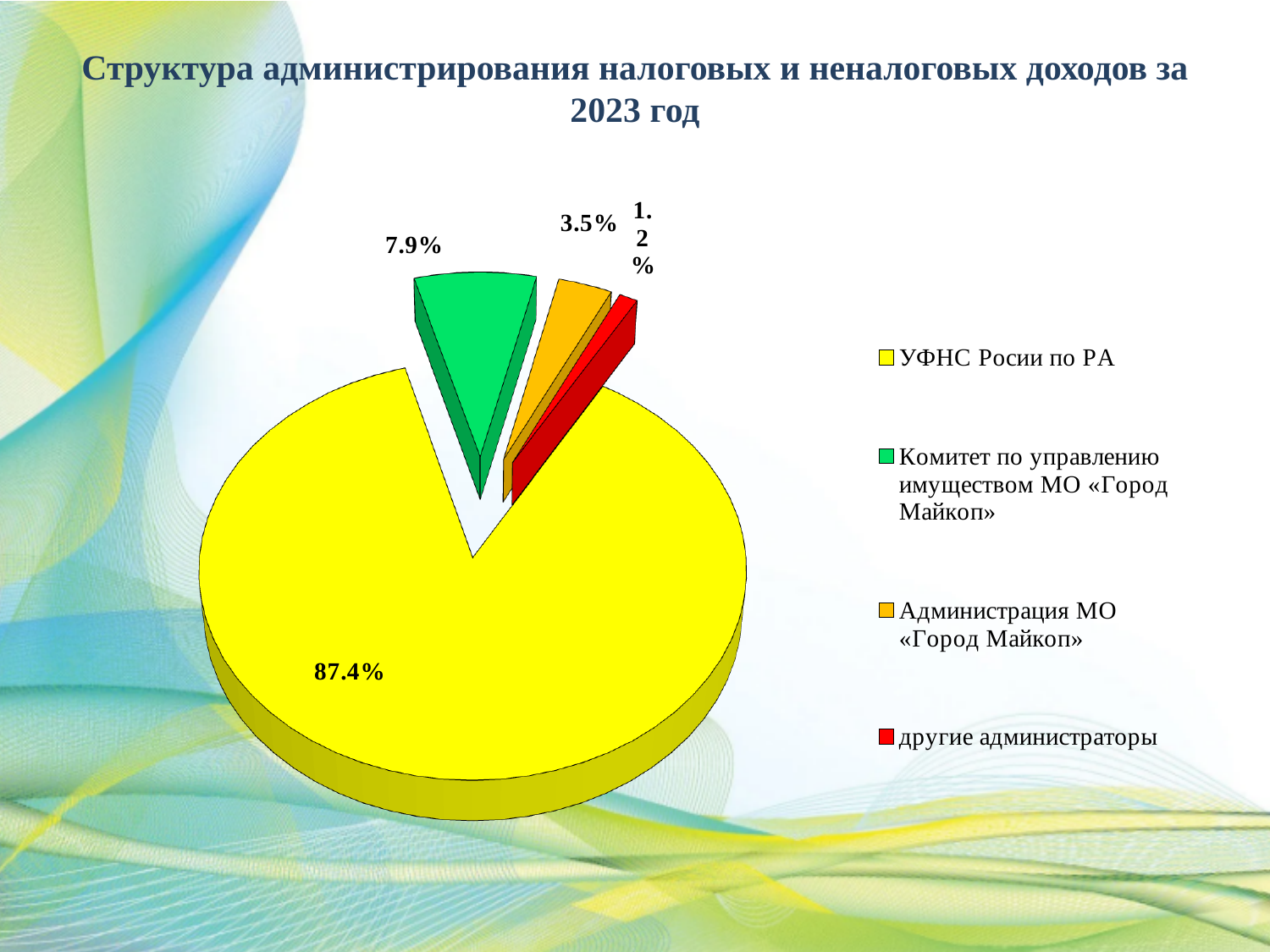
Which is larger: the share of Администрация МО «Город Майкоп» or the share of другие администраторы? Администрация МО «Город Майкоп» What share of the pie does УФНС Росии по РА hold? 87.4% How many categories does the pie chart show? 4 What share of the pie does Администрация МО «Город Майкоп» hold? 3.5% What share of the pie does Комитет по управлению имуществом МО «Город Майкоп» hold? 7.9% What share of the pie does другие администраторы hold? 1.2% Which category has the largest slice of the pie? УФНС Росии по РА Which category has the smallest slice of the pie? другие администраторы What colour is the slice for Комитет по управлению имуществом МО «Город Майкоп»? Green What kind of chart is shown on the slide? Pie chart What is the title of the chart? Структура администрирования налоговых и неналоговых доходов за 2023 год What is the difference in percentage points between the shares of Комитет по управлению имуществом МО «Город Майкоп» and Администрация МО «Город Майкоп»? 4.4